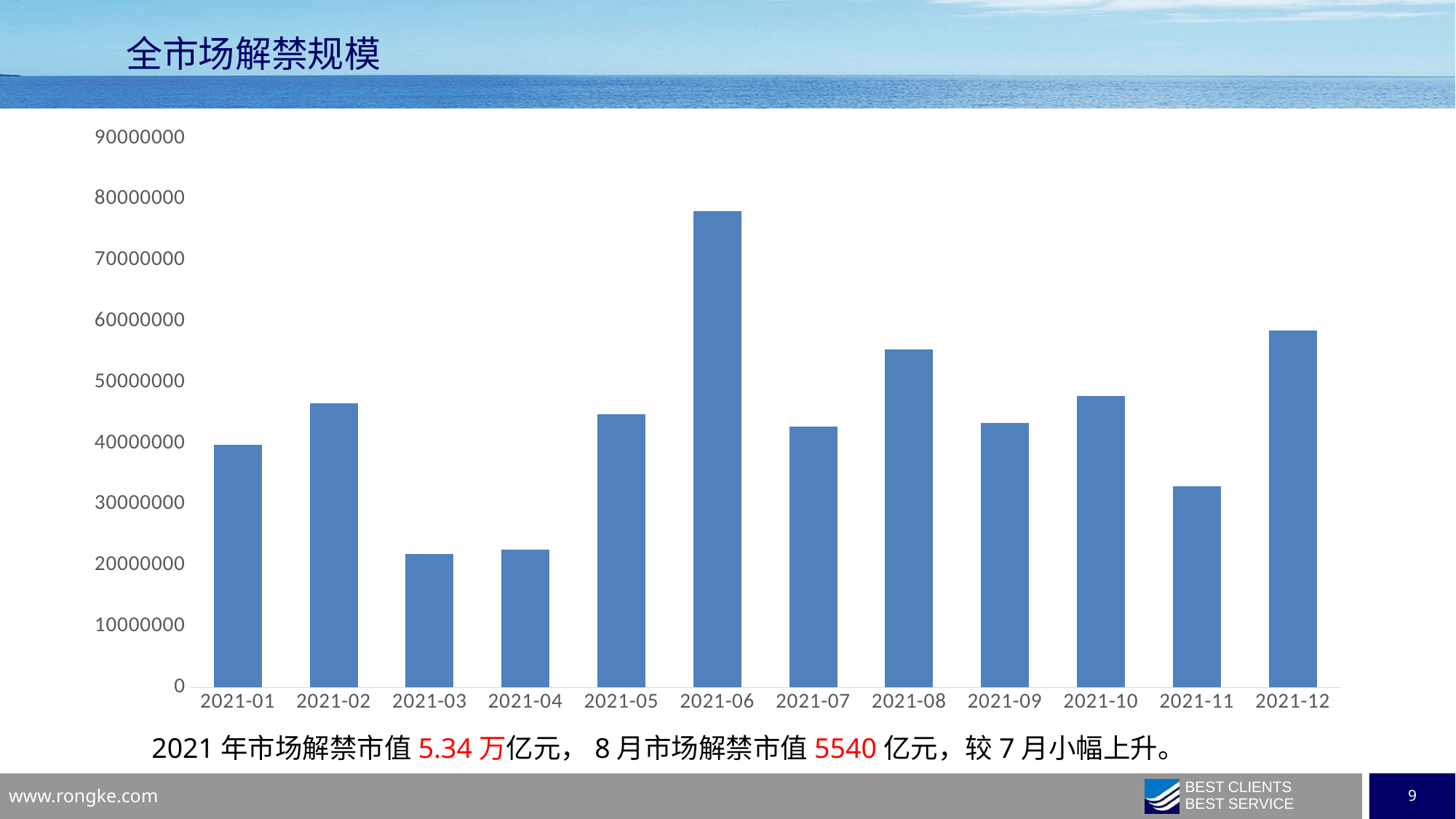
Which is larger, the value for 2021-07 or the value for 2021-08? 2021-08 Do the values rise or fall from 2021-03 to 2021-06? rise Is the value for 2021-02 greater or less than 50000000? less Which is larger, the value for 2021-06 or the value for 2021-12? 2021-06 How many months (categories) are plotted on the x axis? 12 What is the title of the slide containing the chart? 全市场解禁规模 Is the value for 2021-08 greater or less than 50000000? greater Is the value for 2021-12 greater or less than 50000000? greater What kind of chart is shown on the slide? bar chart Which month has the highest bar? 2021-06